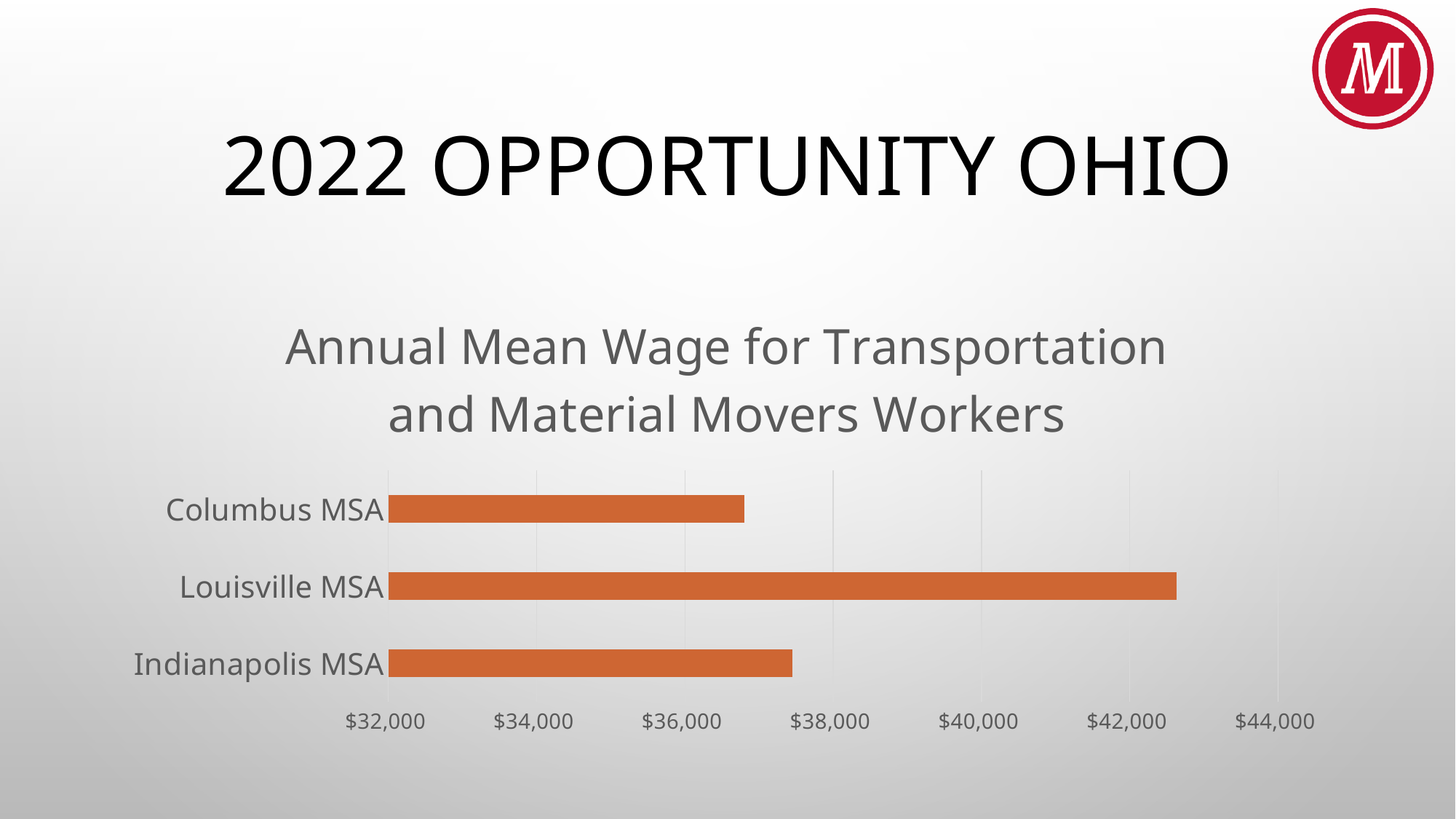
Is the value for Indianapolis MSA greater or less than $38,000? less Which has a higher annual mean wage, Indianapolis MSA or Columbus MSA? Indianapolis MSA Which has a higher annual mean wage, Louisville MSA or Columbus MSA? Louisville MSA Which metropolitan area has the highest annual mean wage for transportation and material movers workers? Louisville MSA How many metropolitan areas (categories) are plotted in the chart? 3 Is the value for Louisville MSA greater or less than $42,000? greater What kind of chart is shown on the slide? Bar chart Which metropolitan area has the lowest annual mean wage for transportation and material movers workers? Columbus MSA What is the title of the chart? Annual Mean Wage for Transportation and Material Movers Workers Is the value for Columbus MSA greater or less than $38,000? less What is the highest value labeled on the chart's horizontal axis? $44,000